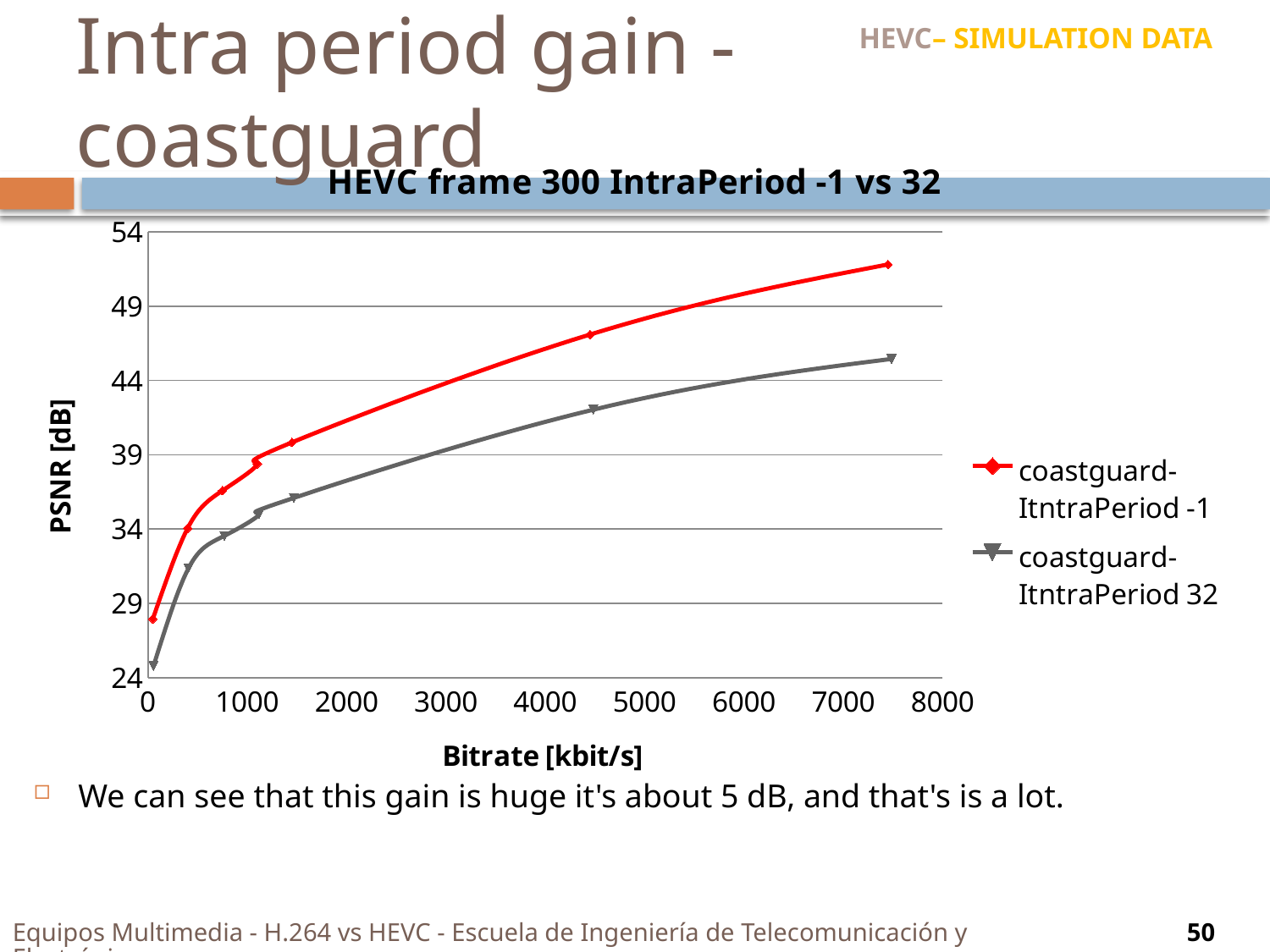
What kind of chart is shown on the slide? line chart Is the PSNR of the coastguard-ItntraPeriod -1 series at its highest bitrate point greater or less than 49? greater What is the title of the chart? HEVC frame 300 IntraPeriod -1 vs 32 Is the PSNR of the coastguard-ItntraPeriod 32 series at its highest bitrate point greater or less than 44? greater Which series has the higher PSNR across the bitrate range, coastguard-ItntraPeriod -1 or coastguard-ItntraPeriod 32? coastguard-ItntraPeriod -1 How many series does the legend list? 2 Is the PSNR of the coastguard-ItntraPeriod -1 series at its lowest bitrate point greater or less than 29? less Does PSNR rise or fall as bitrate increases for the coastguard-ItntraPeriod 32 series? rise What is the label of the y axis? PSNR [dB] Does PSNR rise or fall as bitrate increases for the coastguard-ItntraPeriod -1 series? rise